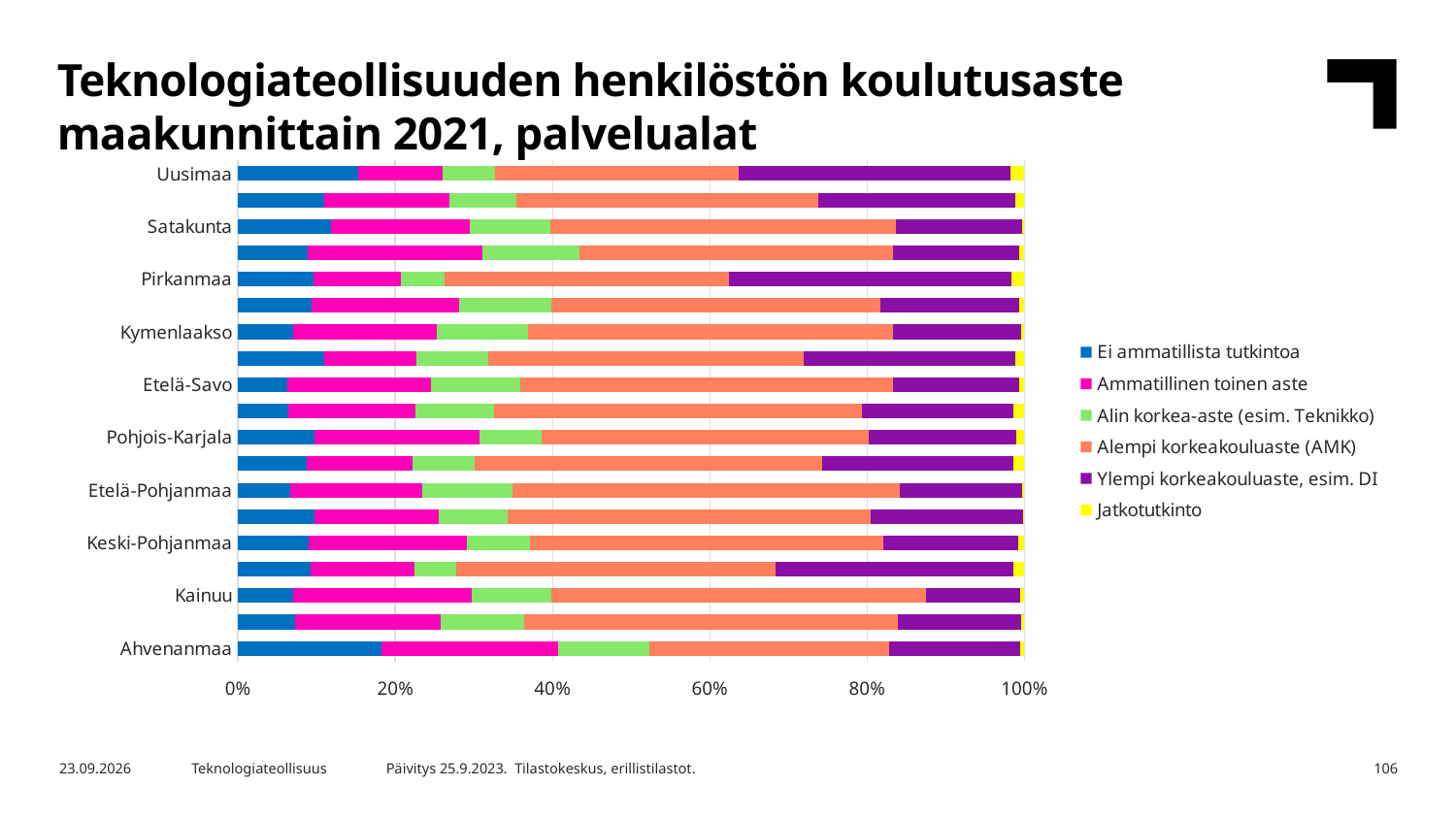
How many bars are plotted in the chart? 19 Is the 'Ei ammatillista tutkintoa' share for Kainuu greater or less than 10%? less How many series does the legend list? 6 Which legend entry is shown in yellow? Jatkotutkinto Is the 'Ylempi korkeakouluaste, esim. DI' share for Uusimaa greater or less than 20%? greater Is the 'Ei ammatillista tutkintoa' share for Ahvenanmaa greater or less than 20%? less Which labelled region has the largest 'Ei ammatillista tutkintoa' share? Ahvenanmaa What is the title of the chart on the slide? Teknologiateollisuuden henkilöstön koulutusaste maakunnittain 2021, palvelualat What kind of chart is shown on the slide? Stacked bar chart Which has the larger 'Ylempi korkeakouluaste, esim. DI' share, Uusimaa or Satakunta? Uusimaa Which has the larger 'Ei ammatillista tutkintoa' share, Ahvenanmaa or Kainuu? Ahvenanmaa